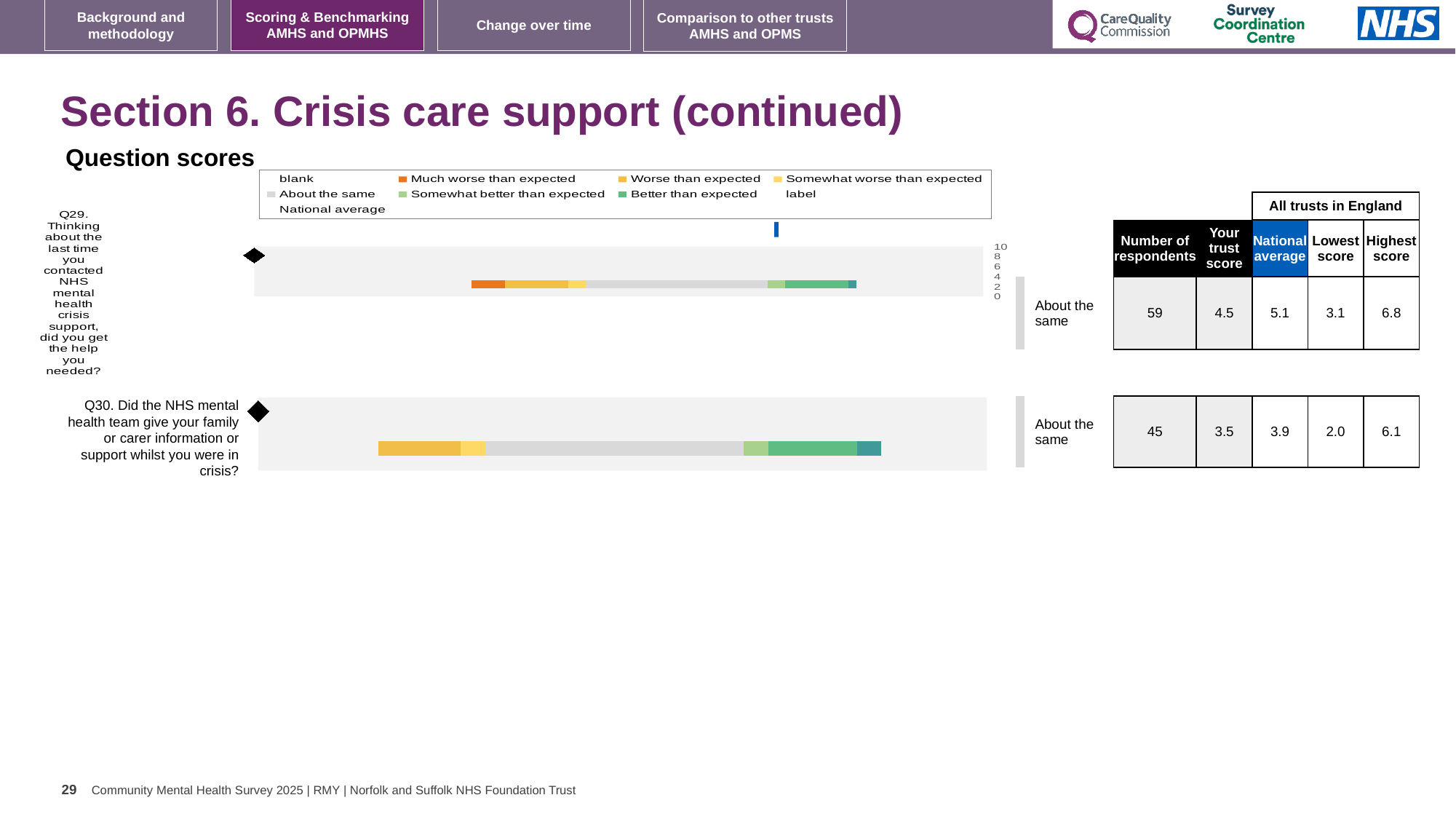
In the table beside the chart, which question has the higher trust score, Q29 or Q30? Q29 In the table beside the chart, what is the national average for Q30? 3.9 In the table beside the chart, what is the difference between the highest score and the lowest score for Q29? 3.7 How many survey questions are plotted as bars on the slide? 2 What kind of chart is used to show the question scores for Q29 and Q30? Bar chart What colour does the legend assign to 'Much worse than expected'? Orange What benchmark category label is shown next to the Q29 bar? About the same In the table beside the chart, what is the difference between the national average and the trust score for Q30? 0.4 In the table beside the chart, how many respondents answered Q30? 45 What benchmark category label is shown next to the Q30 bar? About the same In the table beside the chart, what is the trust score for Q29? 4.5 What colour does the legend assign to 'About the same'? Grey